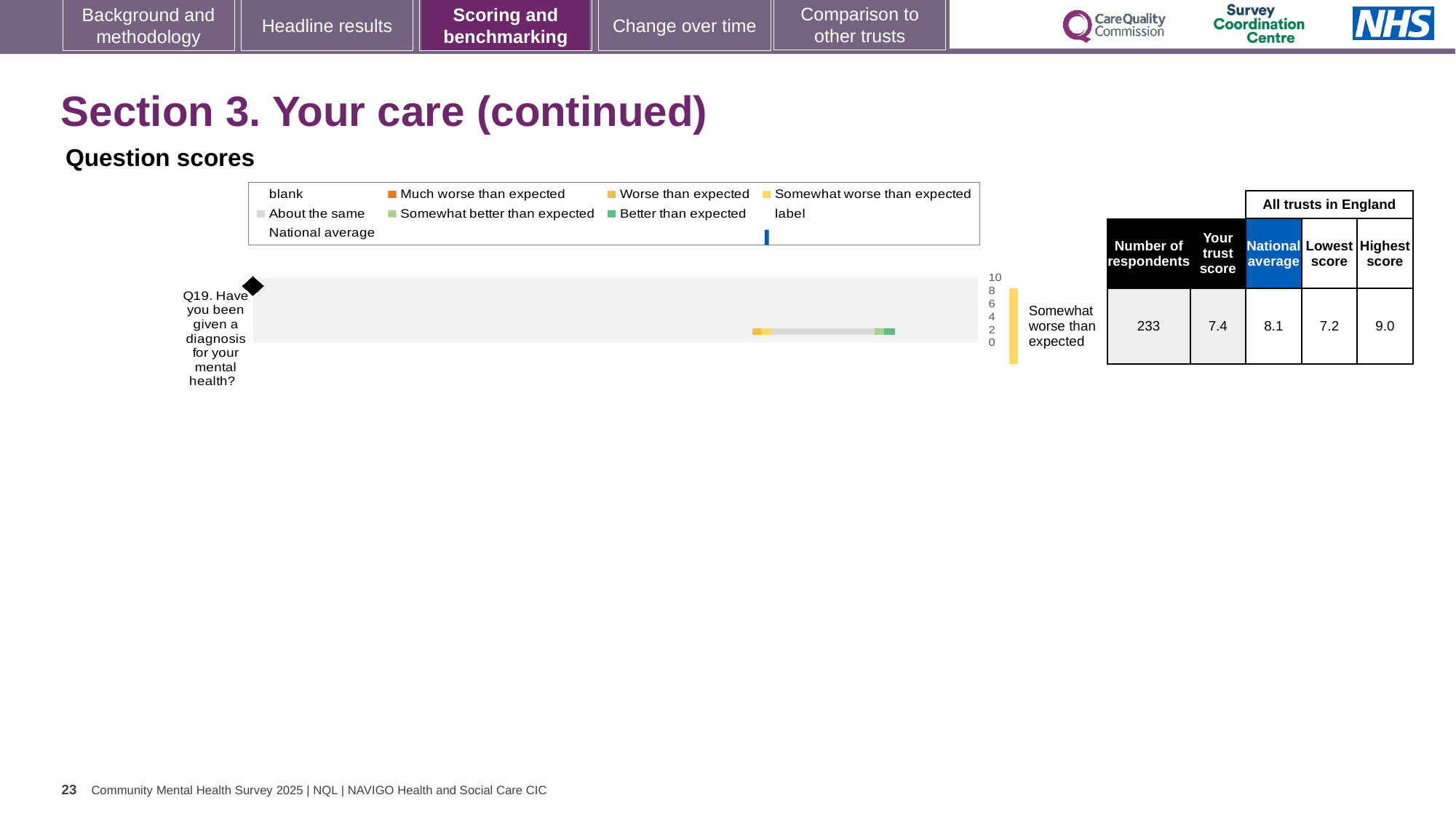
What kind of chart is used to show the question scores? bar chart What is the trust score for Q19? 7.4 What is the difference between the highest and lowest scores for Q19? 1.8 How many respondents answered Q19? 233 What is the highest score among all trusts in England for Q19? 9.0 What is the difference between the national average and the trust score for Q19? 0.7 What is the lowest score among all trusts in England for Q19? 7.2 Which is larger for Q19, the trust score or the national average? National average Which benchmark category is the trust's Q19 score placed in? Somewhat worse than expected How many questions are plotted on the chart? 1 What is the text of the question plotted on the chart? Q19. Have you been given a diagnosis for your mental health? What is the national average score for Q19? 8.1